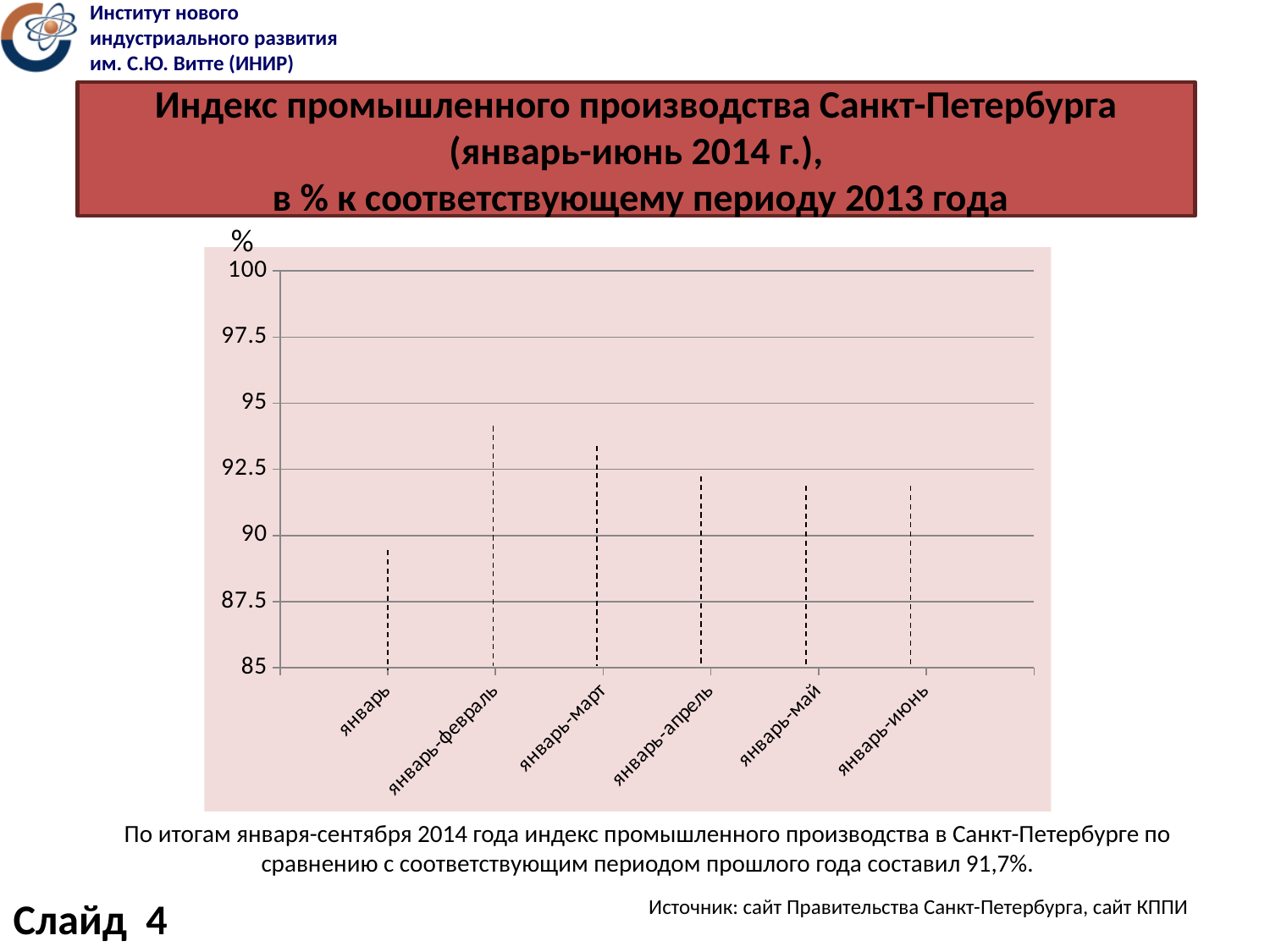
Which is larger, the value for январь-март or the value for январь-апрель? январь-март What unit is shown at the top of the vertical axis of the chart? % Is the value for январь-февраль greater or less than 95? less Is the value for январь-июнь greater or less than 90? greater Is the value for январь-февраль greater or less than 92.5? greater How many categories (periods) are shown on the x axis of the chart? 6 Which period has the lowest value in the chart? январь Which period has the highest value in the chart? январь-февраль From январь-февраль to январь-май, do the values rise or fall? fall What kind of chart is shown on the slide? line chart